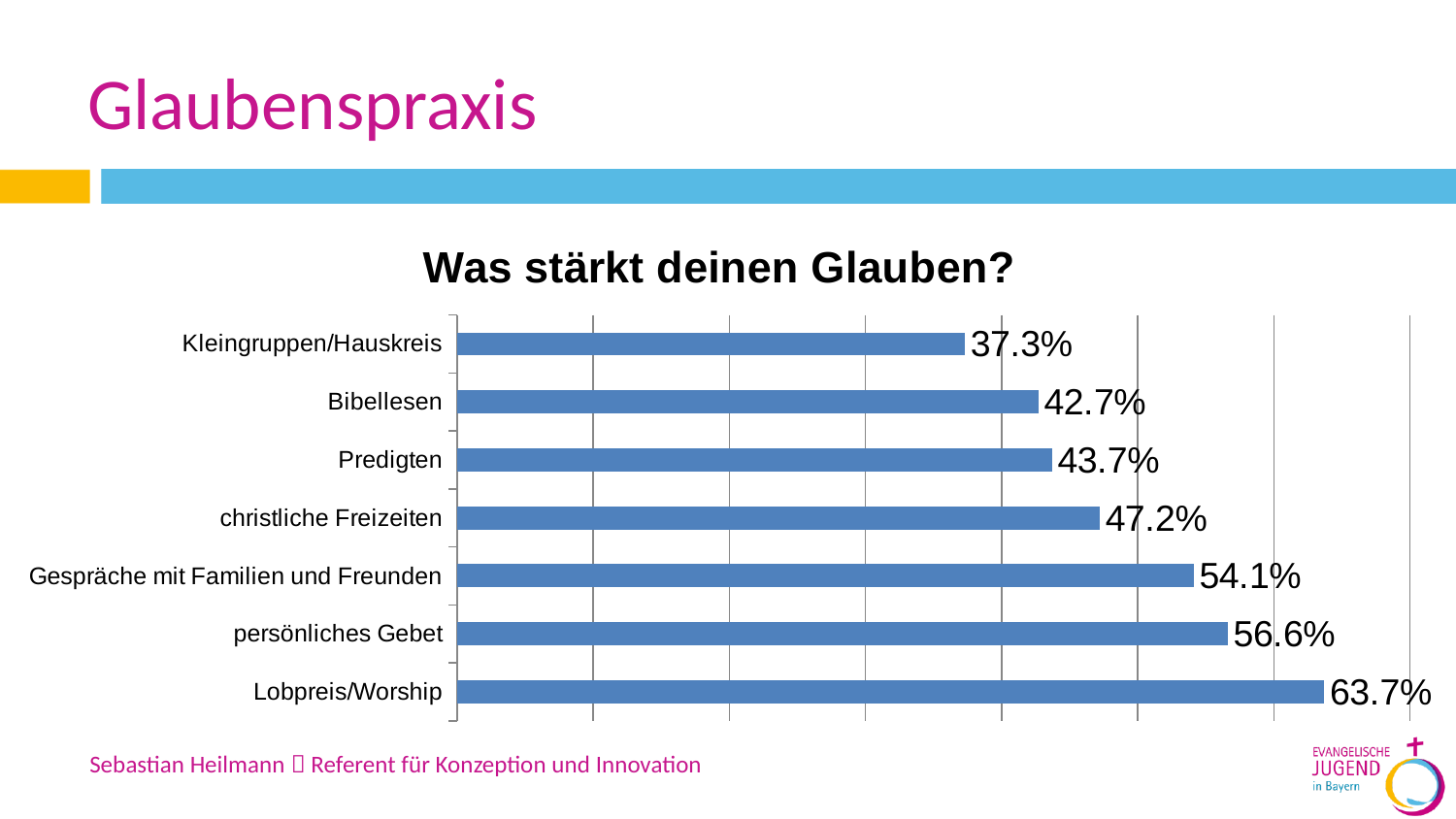
What kind of chart is shown on the slide? Bar chart What is the difference between the values for persönliches Gebet and christliche Freizeiten? 9.4% Which category has the lowest value? Kleingruppen/Hauskreis What is the value for Lobpreis/Worship? 63.7% What is the difference between the values for Lobpreis/Worship and Kleingruppen/Hauskreis? 26.4% What is the title of the chart? Was stärkt deinen Glauben? What is the value for Gespräche mit Familien und Freunden? 54.1% What colour are the bars in the chart? Blue How many categories are shown in the chart? 7 What is the value for Bibellesen? 42.7% Which is larger, the value for Predigten or the value for christliche Freizeiten? christliche Freizeiten Which category has the highest value? Lobpreis/Worship